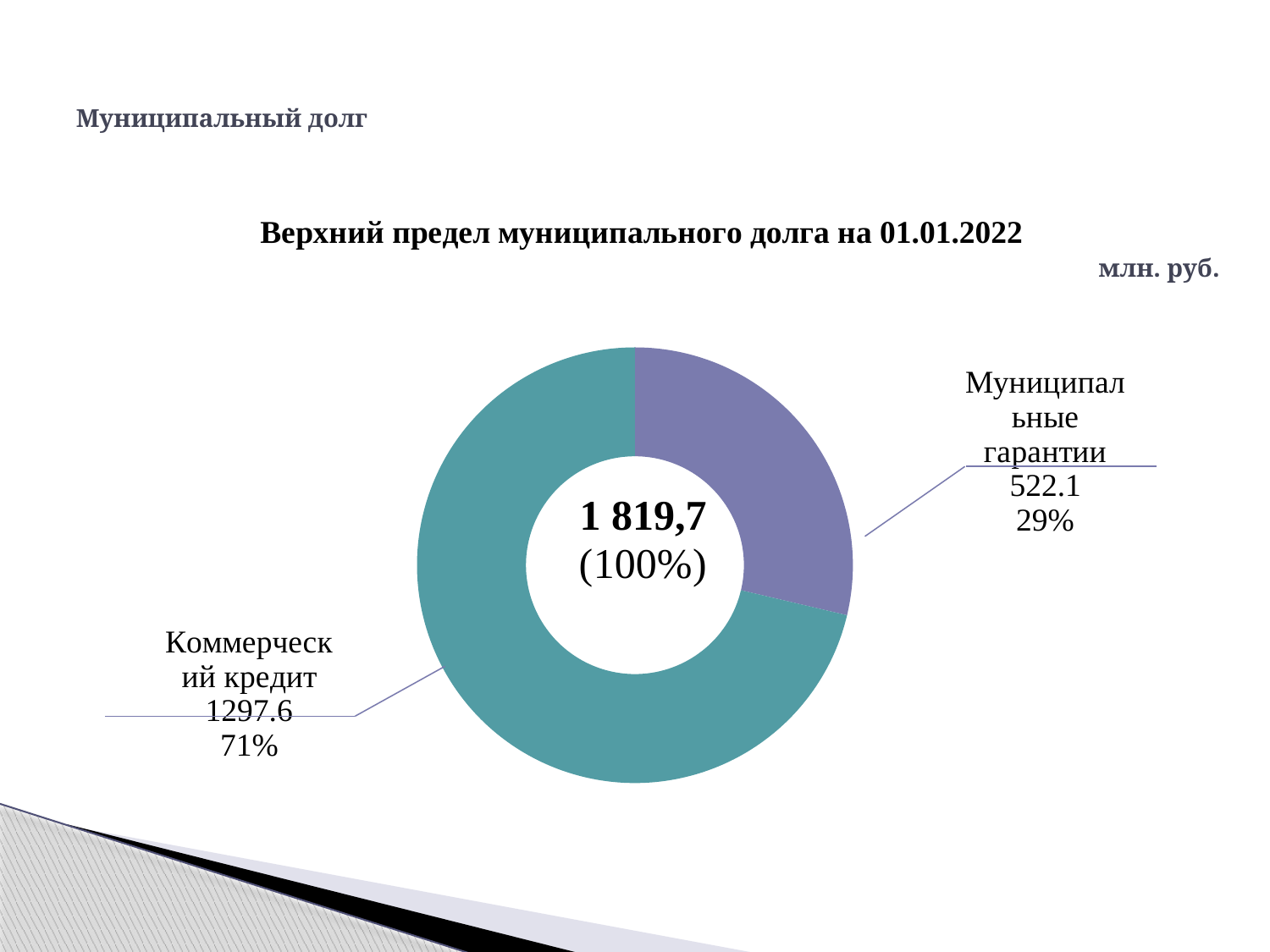
What share of the chart does Муниципальные гарантии represent? 29% What is the value for Коммерческий кредит? 1297.6 What total value is shown in the centre of the chart? 1 819,7 How many categories does the chart show? 2 What share of the chart does Коммерческий кредит represent? 71% What is the title of the chart? Верхний предел муниципального долга на 01.01.2022 What kind of chart is shown on the slide? Pie chart (doughnut) Which category has the largest value? Коммерческий кредит What is the value for Муниципальные гарантии? 522.1 Which is larger, Коммерческий кредит or Муниципальные гарантии? Коммерческий кредит Which category has the smallest value? Муниципальные гарантии What is the difference between the values for Коммерческий кредит and Муниципальные гарантии? 775.5